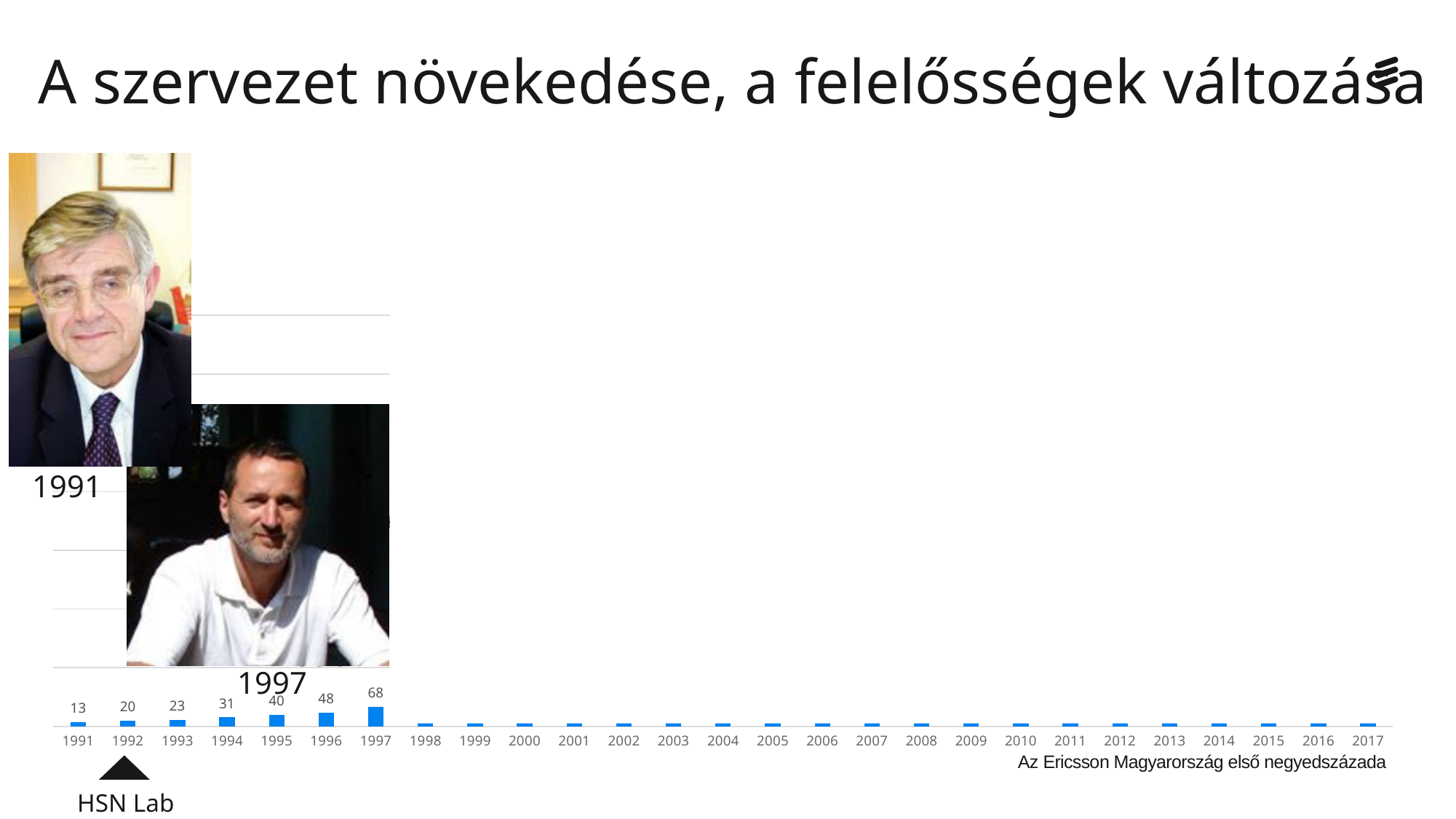
What is the value shown for 1991? 13 What is the value shown for 1994? 31 What kind of chart is shown on the slide? bar chart Which is larger, the value for 1992 or the value for 1996? 1996 What is the difference between the values for 1993 and 1991? 10 How many years are shown on the x axis of the chart? 27 What is the value shown for 1995? 40 Which year has the tallest bar on the chart? 1997 What is the difference between the values for 1997 and 1996? 20 Do the values rise or fall from 1991 to 1997? rise What is the value shown for 1997? 68 What label is written under the arrow marker below the 1992 bar? HSN Lab